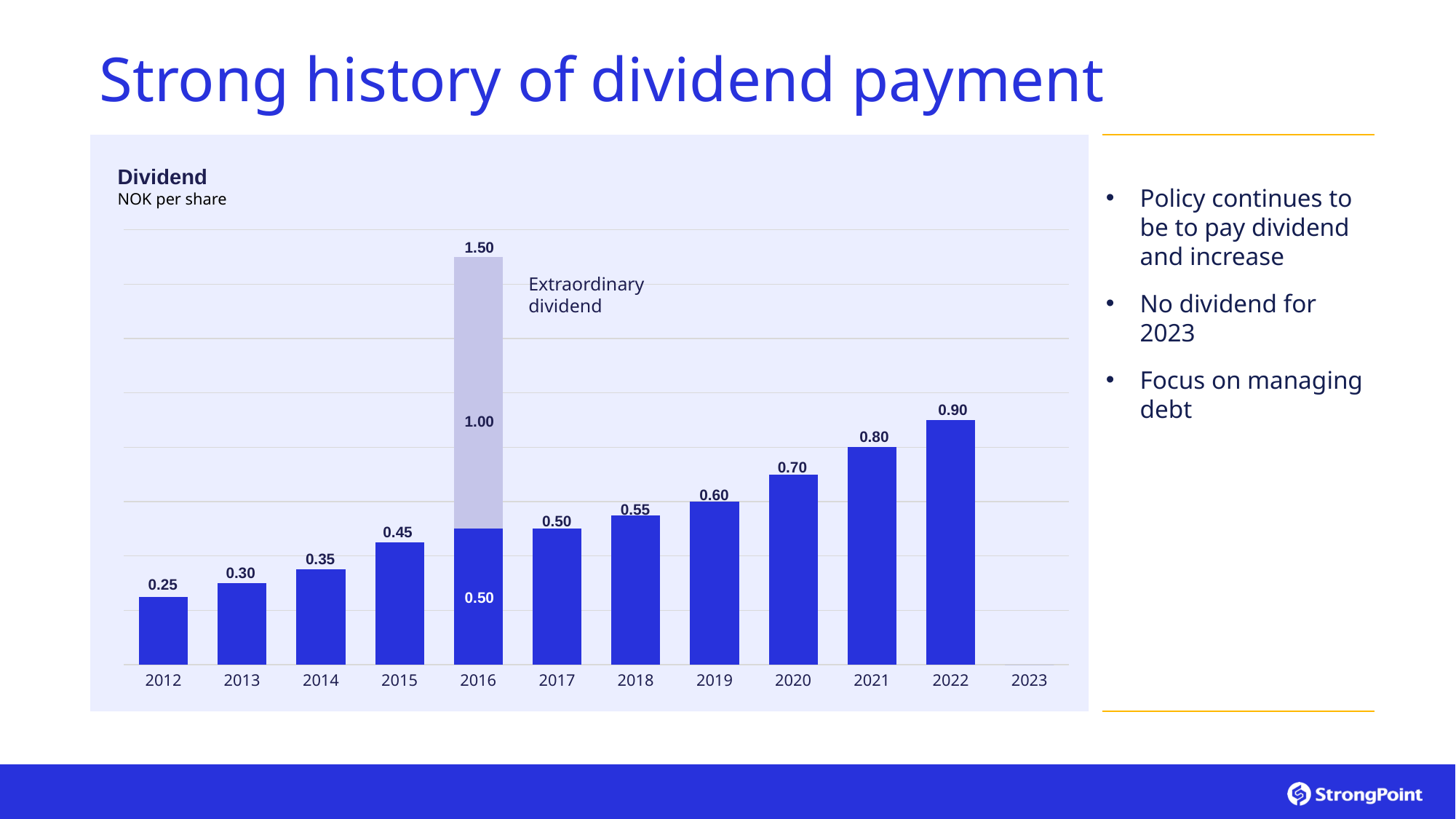
What is the dividend per share for 2022? 0.90 Which year has the larger dividend per share, 2018 or 2019? 2019 What is the extraordinary dividend per share shown for 2016? 1.00 Which year has the lowest non-zero dividend per share? 2012 Which year has the highest total dividend per share? 2016 What is the dividend per share for 2012? 0.25 What is the difference between the dividend per share in 2022 and in 2021? 0.10 What is the total dividend per share for 2016, including the extraordinary dividend? 1.50 How many years are shown on the x axis of the chart? 12 What type of chart is used to show the dividend per share? Bar chart Excluding the extraordinary dividend in 2016, do the dividends per share rise or fall from 2012 to 2022? Rise What is the ordinary dividend per share for 2016, excluding the extraordinary dividend? 0.50